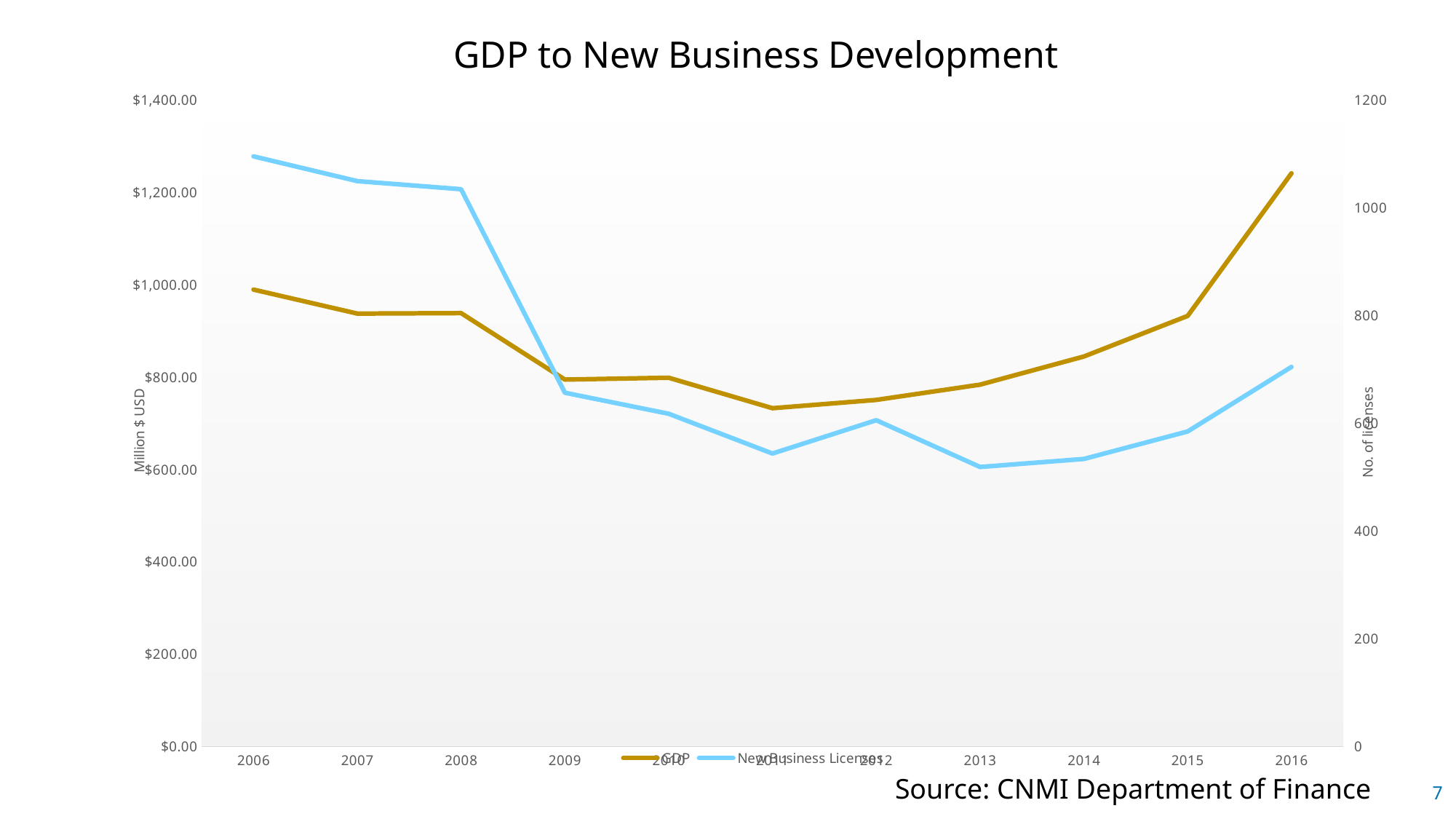
Is the New Business Licenses value for 2006 greater or less than 1000? greater What kind of chart is shown on the slide? line chart Does the New Business Licenses line rise or fall from 2006 to 2011? fall How many series does the legend list? 2 In which year is GDP highest? 2016 In which year is GDP lowest? 2011 In which year is the number of New Business Licenses highest? 2006 Is the GDP value for 2016 greater or less than $1,200.00? greater Which year has more New Business Licenses, 2008 or 2009? 2008 How many years are plotted along the x axis? 11 What is the title of the left vertical axis? Million $ USD Is the GDP value for 2011 greater or less than $800.00? less